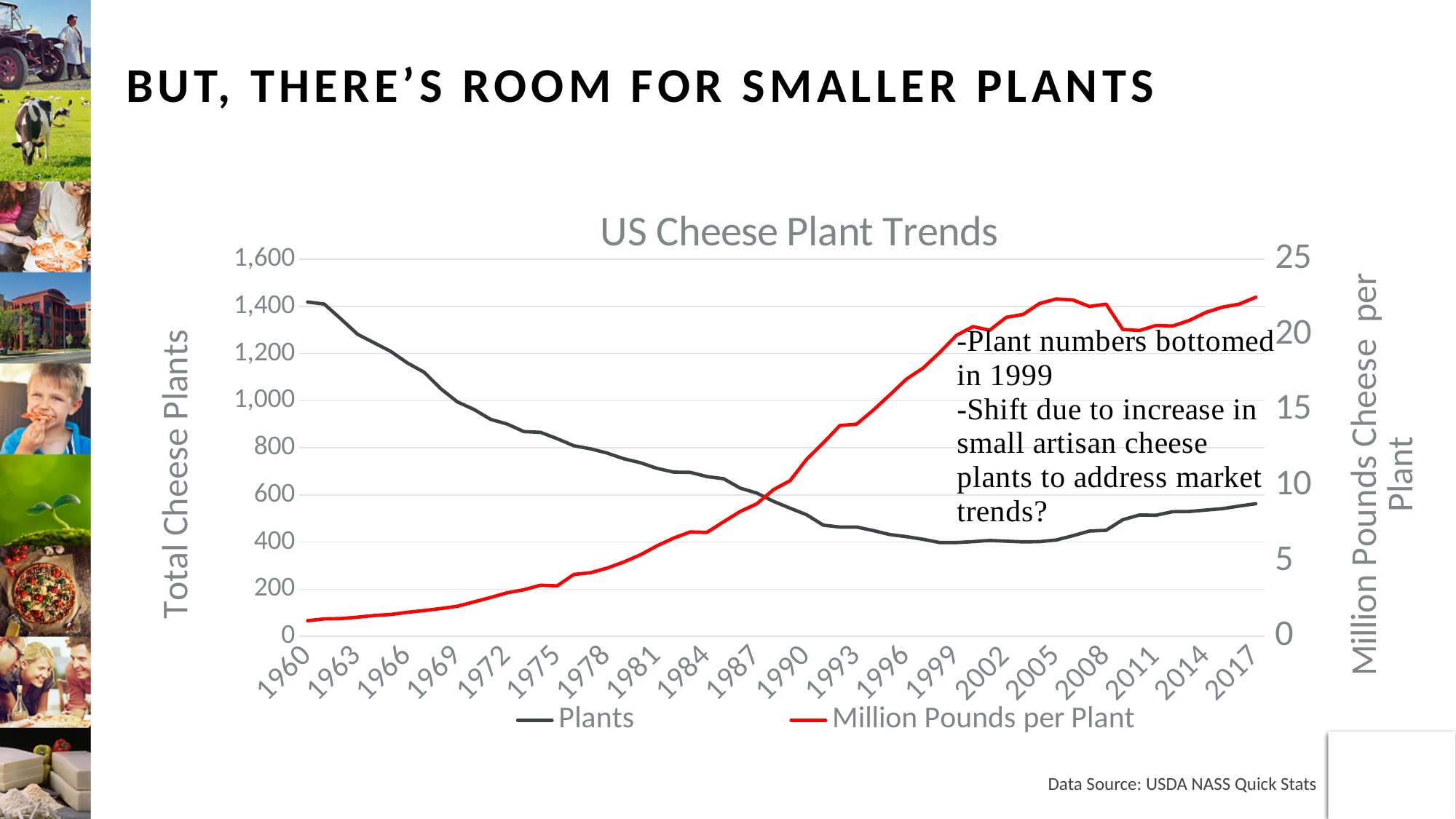
How many series does the legend of the US Cheese Plant Trends chart list? 2 Is the value for Plants in 1960 greater or less than 1,200? greater Does the Million Pounds per Plant series rise or fall from 1960 to 2017 overall? Rise Does the Plants series rise or fall between 1960 and 1999? Fall Which series is drawn in red in the chart? Million Pounds per Plant In which year is the Million Pounds per Plant series at its lowest? 1960 In which year is the Plants series at its highest? 1960 What kind of chart is shown on the slide? Line chart Is the value for Million Pounds per Plant in 1960 greater or less than 5? less What is the title of the chart? US Cheese Plant Trends Is the value for Plants in 1999 greater or less than 600? less